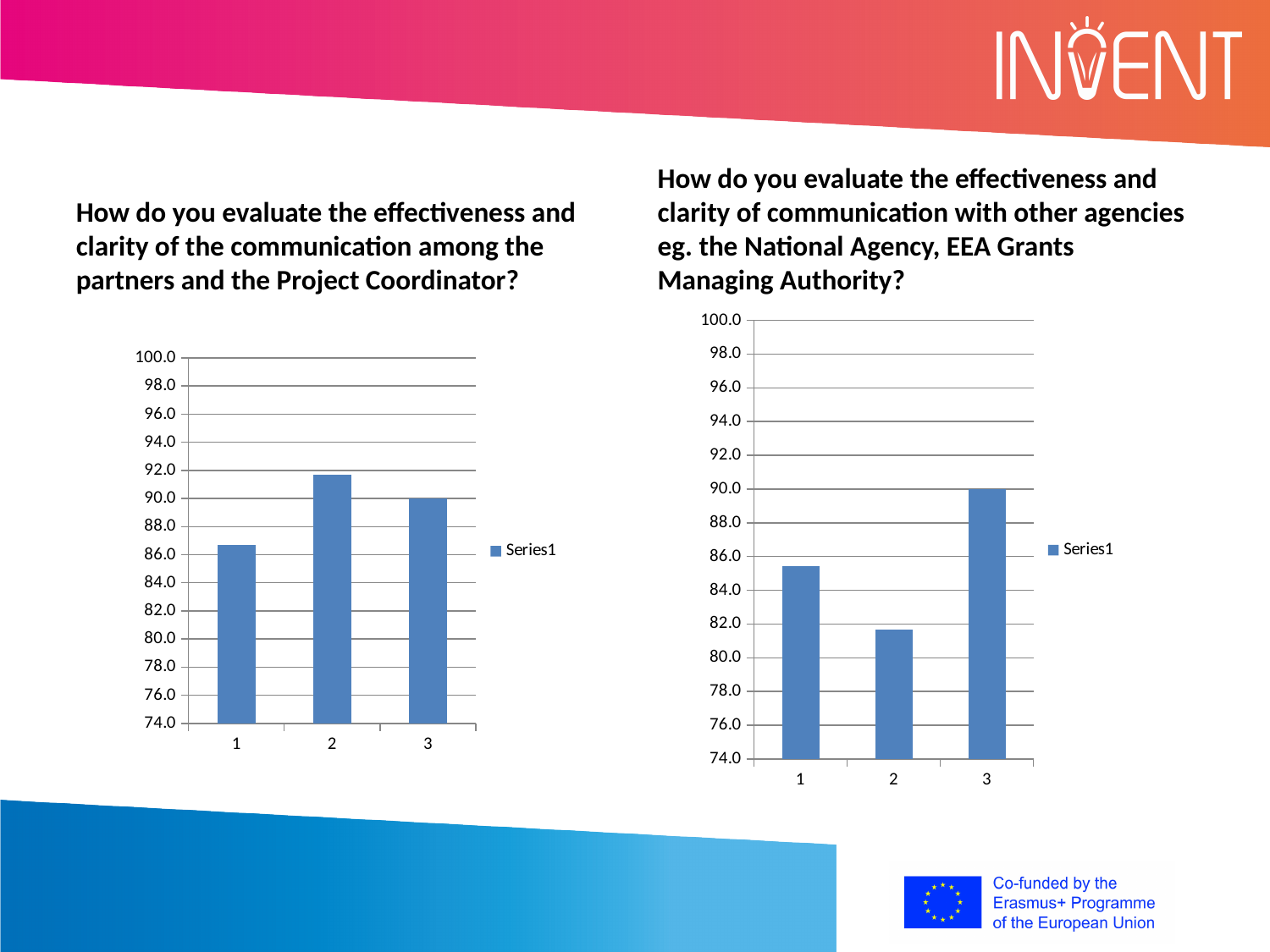
On the left chart (communication among partners and the Project Coordinator), what kind of chart is shown? bar chart On the right chart (communication with other agencies), which is larger, the value for category 1 or category 2? category 1 On the right chart (communication with other agencies), which category has the highest value? 3 On the left chart (communication among partners and the Project Coordinator), is the value for category 2 greater or less than 90.0? greater On the left chart (communication among partners and the Project Coordinator), which category has the lowest value? 1 On the left chart (communication among partners and the Project Coordinator), is the value for category 1 greater or less than 88.0? less On the left chart (communication among partners and the Project Coordinator), which category has the highest value? 2 On the right chart (communication with other agencies), which category has the lowest value? 2 On the right chart (communication with other agencies), how many series does the legend list? 1 On the right chart (communication with other agencies), what is the name of the series shown in the legend? Series1 On the right chart (communication with other agencies), is the value for category 2 greater or less than 84.0? less On the left chart (communication among partners and the Project Coordinator), how many categories are on the x axis? 3